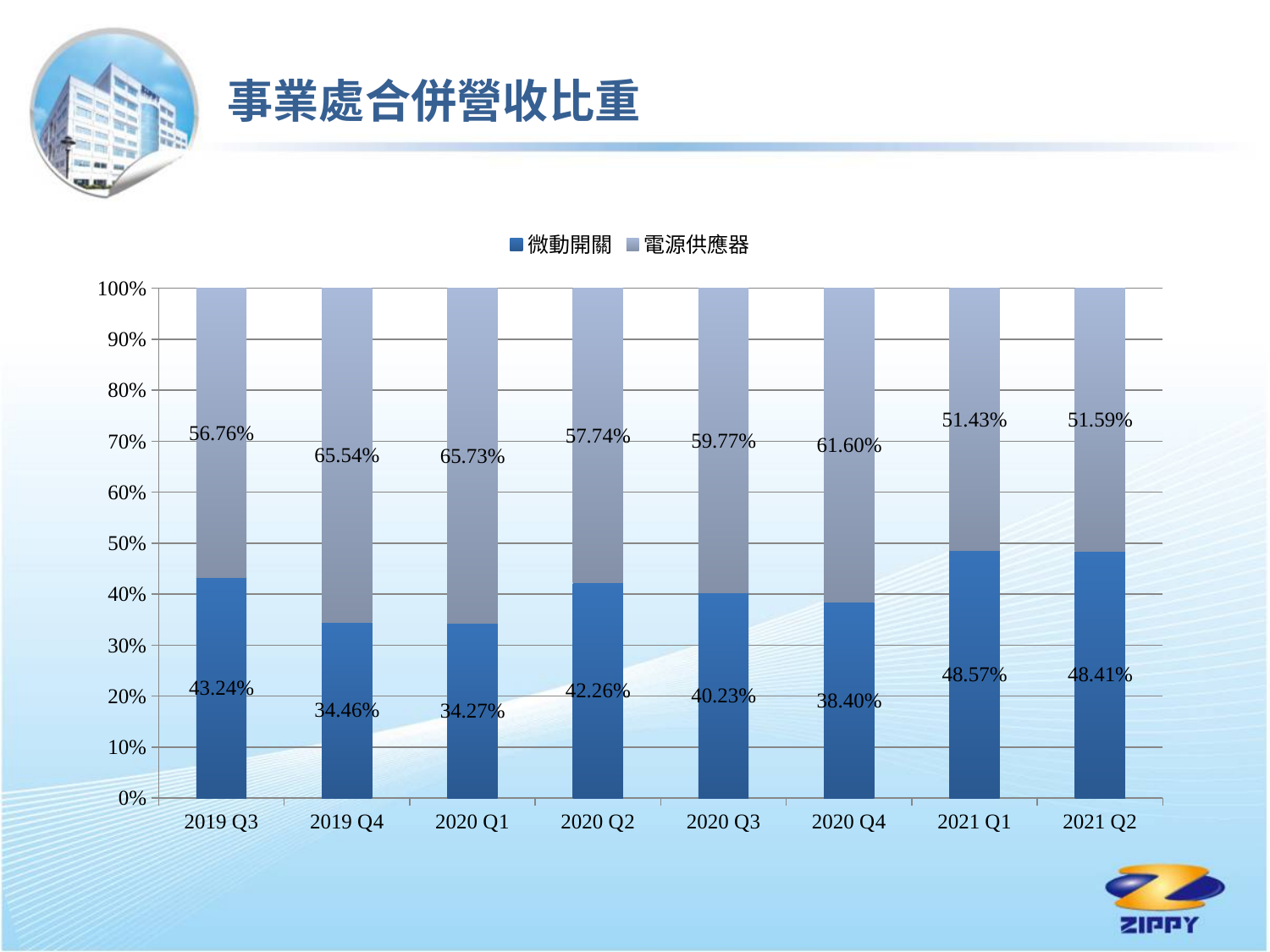
In which quarter is the 電源供應器 share highest? 2020 Q1 What is the value for 微動開關 in 2019 Q3? 43.24% What kind of chart is shown on the slide? Stacked bar chart What is the title of the slide? 事業處合併營收比重 What is the value for 電源供應器 in 2020 Q4? 61.60% How many series does the legend list? 2 Which is larger in 2020 Q2: the 微動開關 share or the 電源供應器 share? 電源供應器 What is the difference between the 電源供應器 and 微動開關 shares in 2019 Q4? 31.08% In which quarter is the 微動開關 share lowest? 2020 Q1 In which quarter is the 微動開關 share highest? 2021 Q1 What is the value for 微動開關 in 2021 Q2? 48.41% How many quarters are shown on the x axis? 8